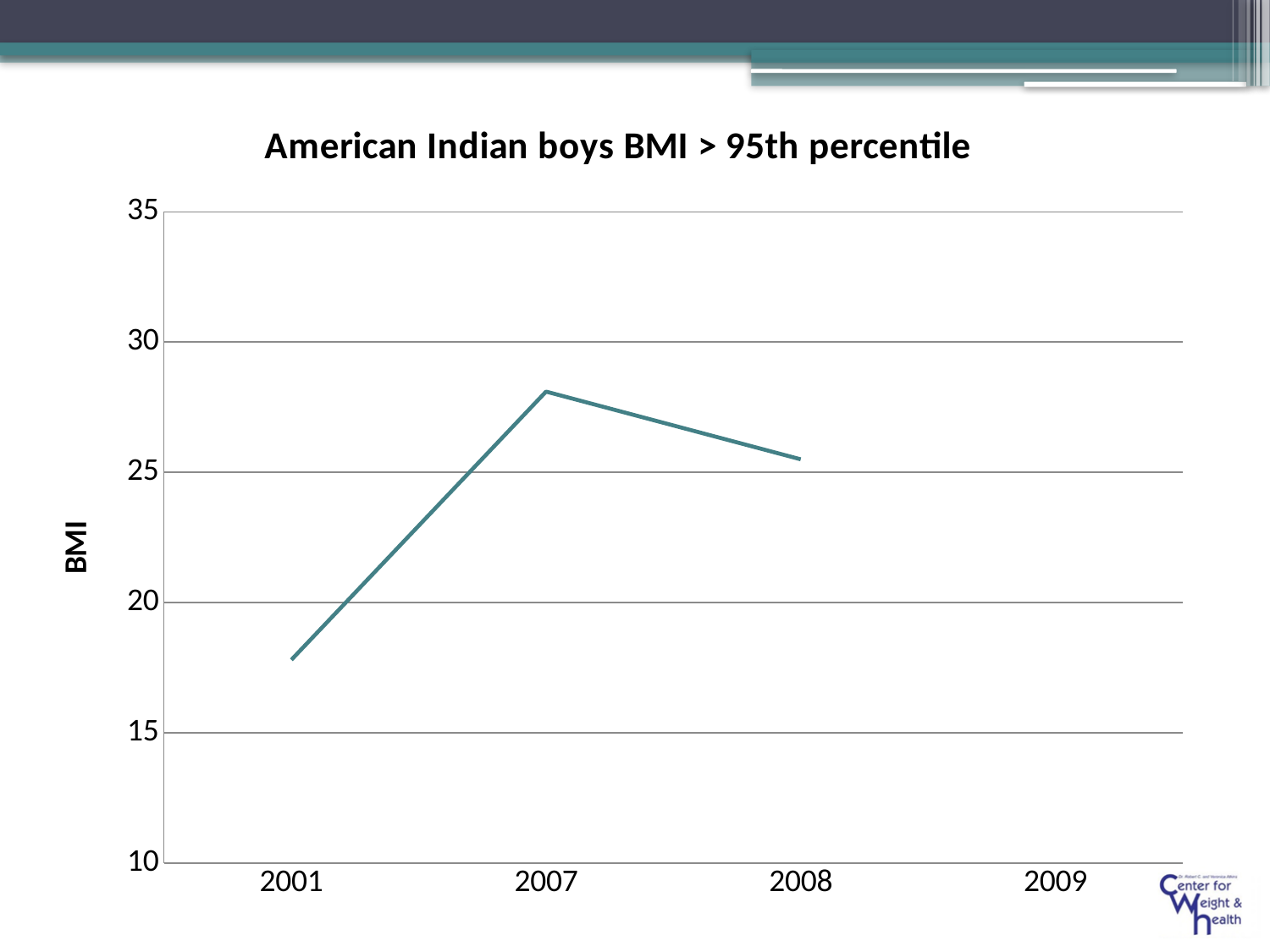
Which year has a larger BMI value, 2007 or 2008? 2007 Is the BMI value for 2007 greater or less than 25? greater Is the BMI value for 2001 greater or less than 20? less What is the label on the vertical axis? BMI Which year has a larger BMI value, 2001 or 2008? 2008 What is the title of the chart? American Indian boys BMI > 95th percentile Which year has the highest BMI value on the chart? 2007 How many data points are plotted on the line? 3 Is the BMI value for 2008 greater or less than 30? less Does the BMI value rise or fall from 2007 to 2008? fall Which year has the lowest BMI value on the chart? 2001 What kind of chart is shown on the slide? line chart